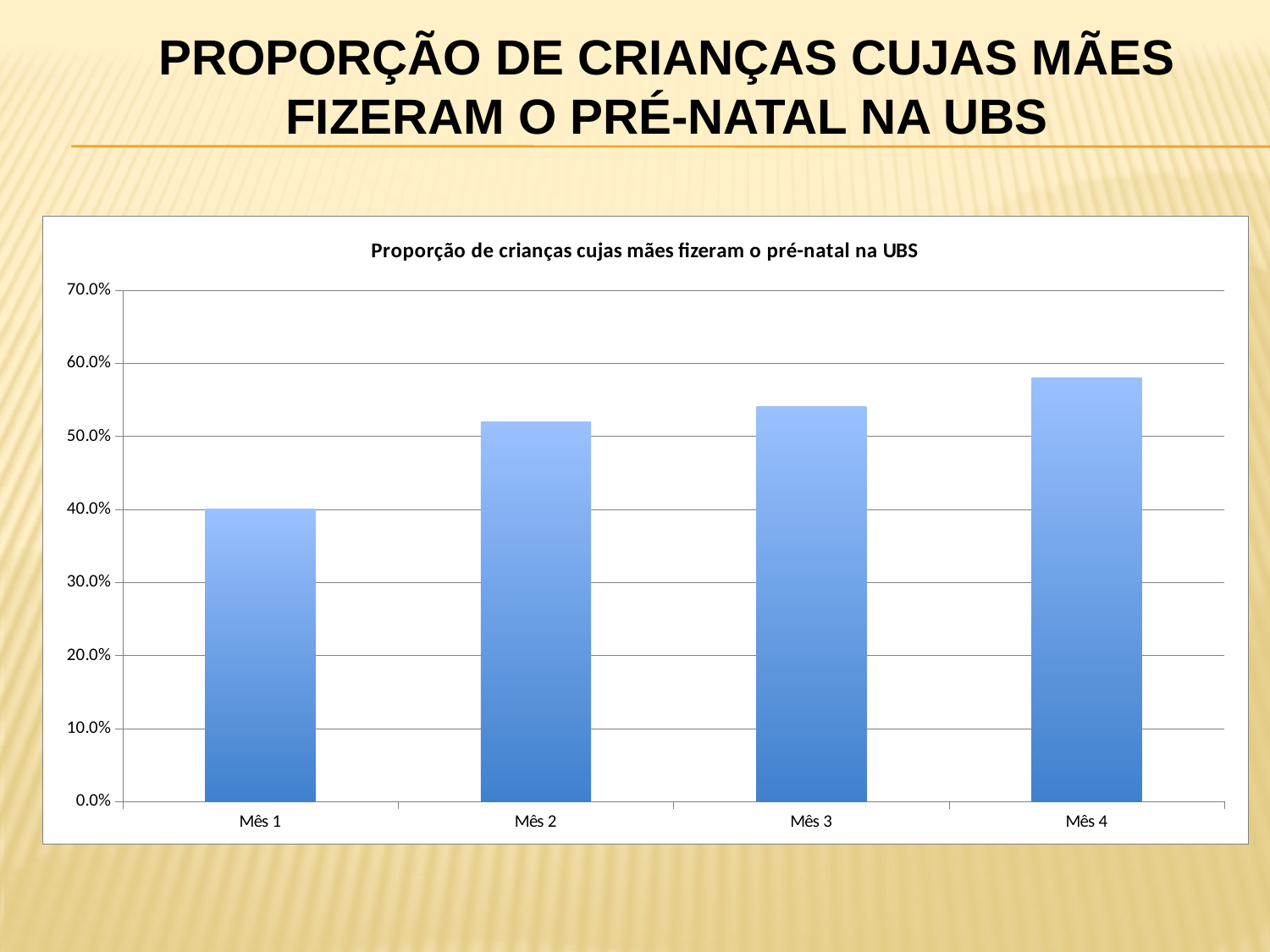
Which month has the lowest proportion on the chart? Mês 1 Which month has the highest proportion of children whose mothers did prenatal care at the UBS? Mês 4 How many months (categories) are plotted on the chart? 4 Is the value for Mês 2 greater or less than 50.0%? greater Is the value for Mês 2 greater or less than 60.0%? less Is the value for Mês 3 greater or less than 60.0%? less What kind of chart is shown on the slide? Bar chart Which is larger, the value for Mês 1 or the value for Mês 4? Mês 4 What is the value for Mês 1? 40.0% Do the values rise or fall from Mês 1 to Mês 4? Rise What is the title printed inside the chart area? Proporção de crianças cujas mães fizeram o pré-natal na UBS